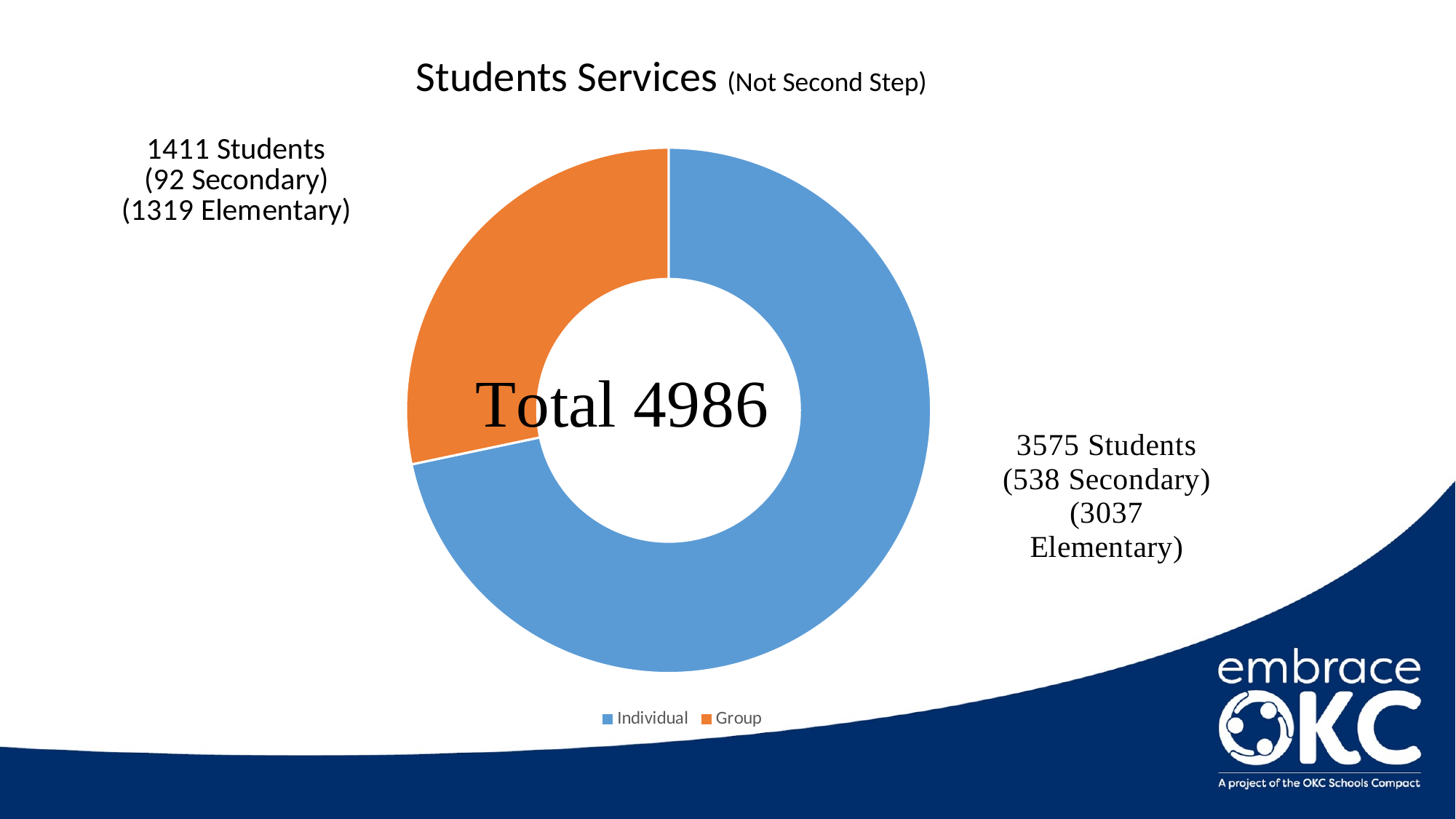
How many students received Group services? 1411 Students How many Secondary students are included in the Individual slice? 538 Which colour represents the Group category in the chart? orange What is the total number of students shown in the centre of the chart? Total 4986 Which category has the larger slice, Individual or Group? Individual Which category has the smallest slice? Group How many Elementary students are included in the Group slice? 1319 How many series does the legend list? 2 What is the difference between the number of Individual students and Group students? 2164 What is the title of the chart? Students Services (Not Second Step) How many students received Individual services? 3575 Students What kind of chart is shown on the slide? doughnut chart